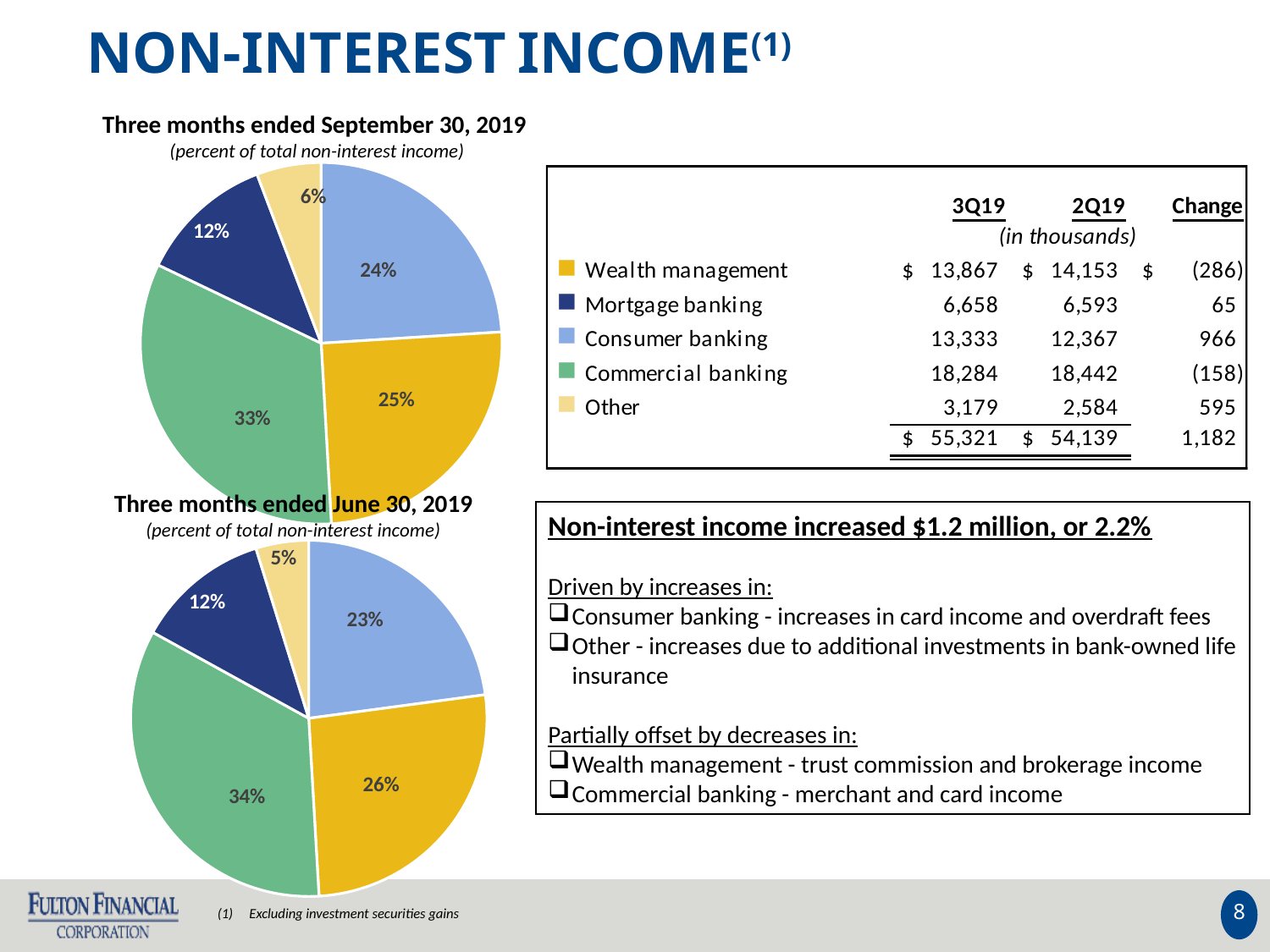
What is the subtitle shown under both pie chart titles? (percent of total non-interest income) What kind of chart is used for 'Three months ended September 30, 2019'? pie chart In the 'Three months ended September 30, 2019' pie chart, which category has the largest share? Commercial banking How many slices are in the 'Three months ended June 30, 2019' pie chart? 5 In the 'Three months ended September 30, 2019' pie chart, what share does commercial banking (green slice) have? 33% In the 'Three months ended June 30, 2019' pie chart, what is the difference in percentage points between commercial banking and wealth management? 8 In the 'Three months ended June 30, 2019' pie chart, what share does consumer banking (light blue slice) have? 23% In the 'Three months ended June 30, 2019' pie chart, which is larger: the wealth management share or the consumer banking share? Wealth management In the 'Three months ended September 30, 2019' pie chart, which category has the smallest share? Other In the 'Three months ended September 30, 2019' pie chart, what share does wealth management (gold slice) have? 25% In the 'Three months ended September 30, 2019' pie chart, what is the difference in percentage points between mortgage banking and other? 6 In the 'Three months ended June 30, 2019' pie chart, what share does the 'Other' slice have? 5%